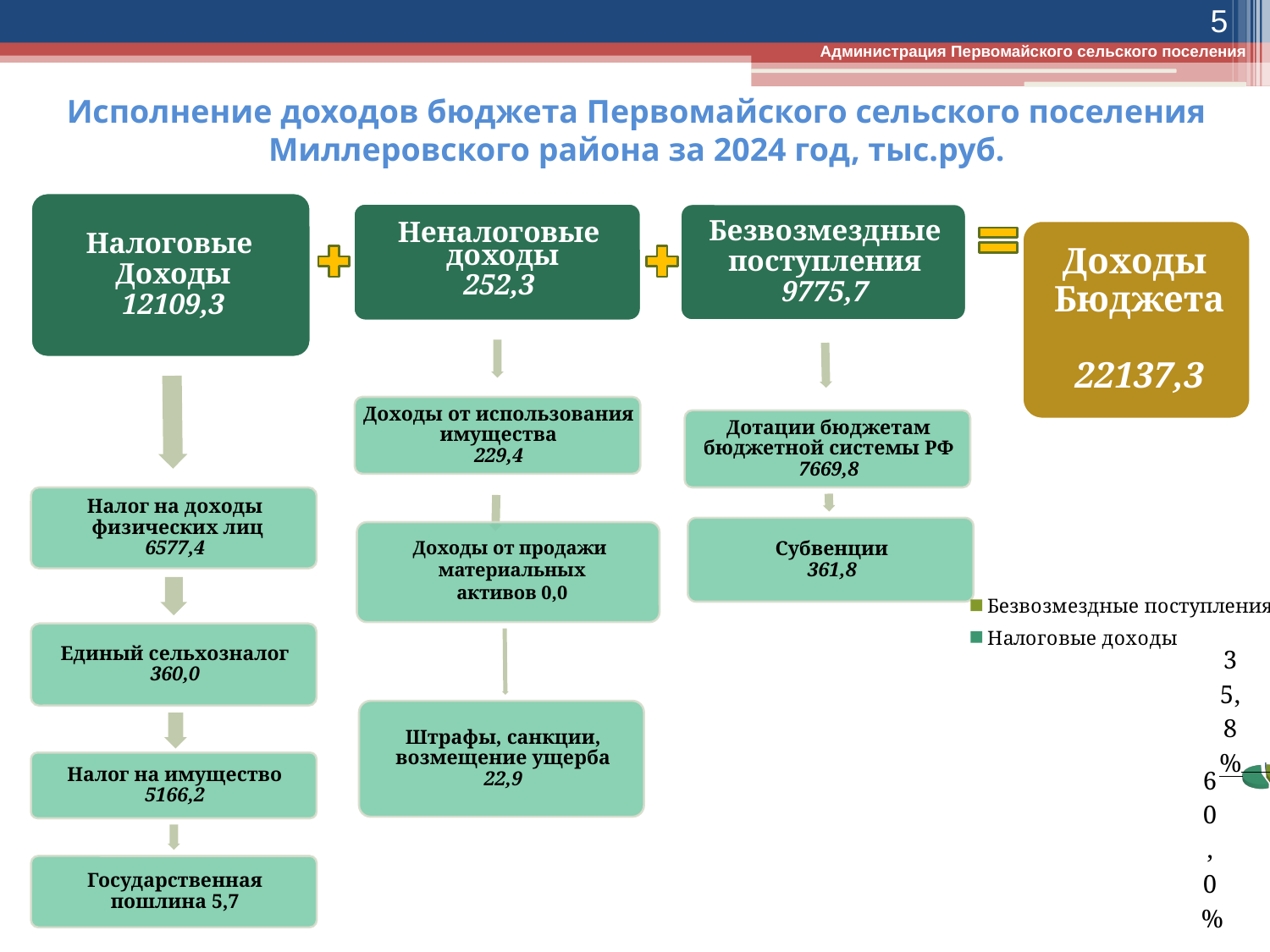
How many entries does the legend of the pie chart list? 2 What is the second entry in the pie chart's legend? Налоговые доходы Of the two percentage labels printed next to the pie chart, which is larger? 60,0% What is the first entry in the pie chart's legend? Безвозмездные поступления Which two percentage labels are printed next to the pie chart? 35,8% and 60,0% What kind of chart is shown in the bottom-right corner of the slide? pie chart